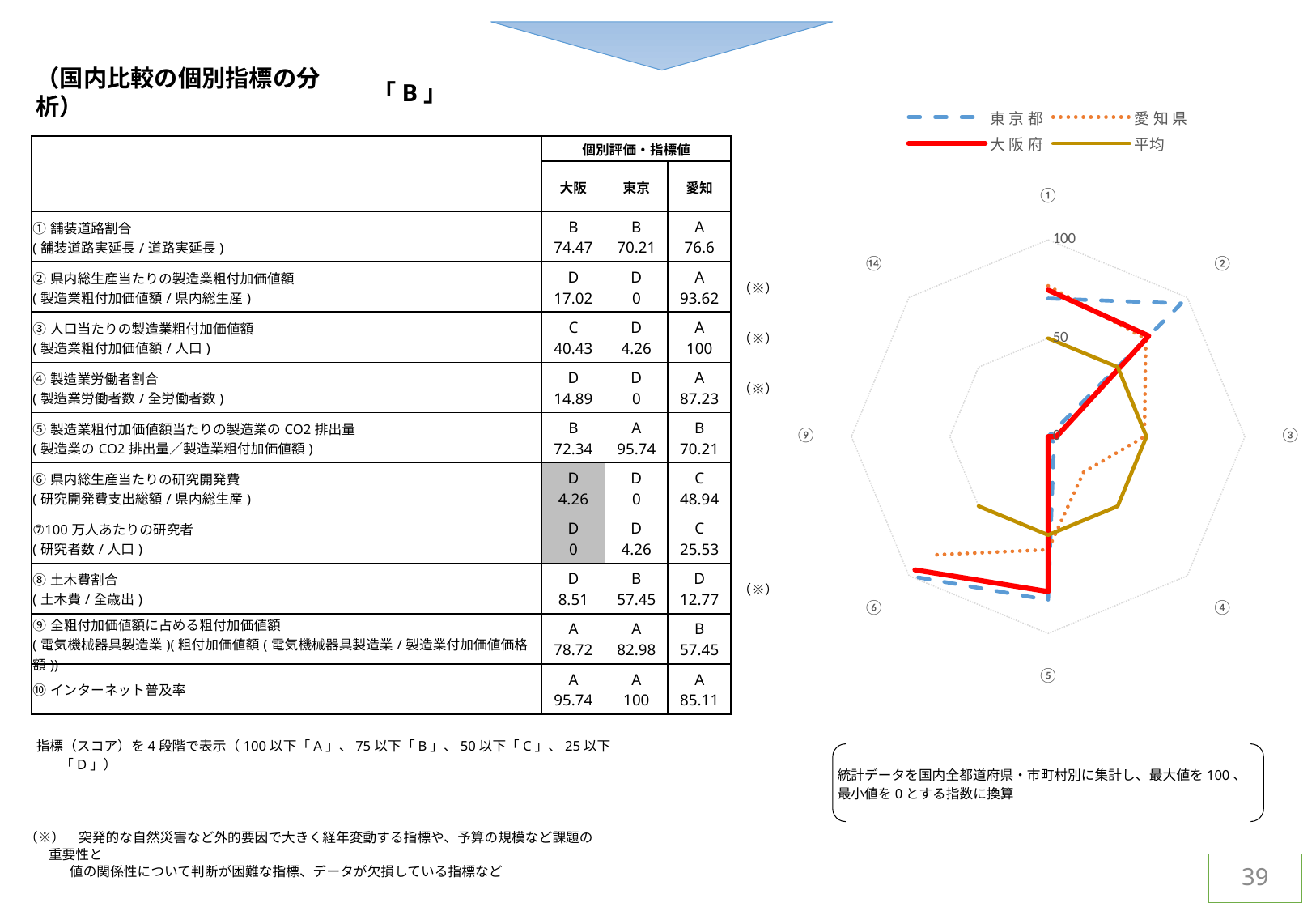
In the radar chart, is the value for 東京都 on axis ④ greater or less than 50? less In the radar chart, is the value for 大阪府 on axis ① greater or less than 50? greater Which series in the radar chart is drawn with a dashed blue line? 東京都 What kind of chart is shown on the right side of the slide? radar chart Which series in the radar chart is drawn with a solid red line? 大阪府 In the radar chart, is the value for 東京都 on axis ② greater or less than 50? greater How many series does the legend of the radar chart list? 4 In the radar chart, which series has the larger value on axis ③, 愛知県 or 東京都? 愛知県